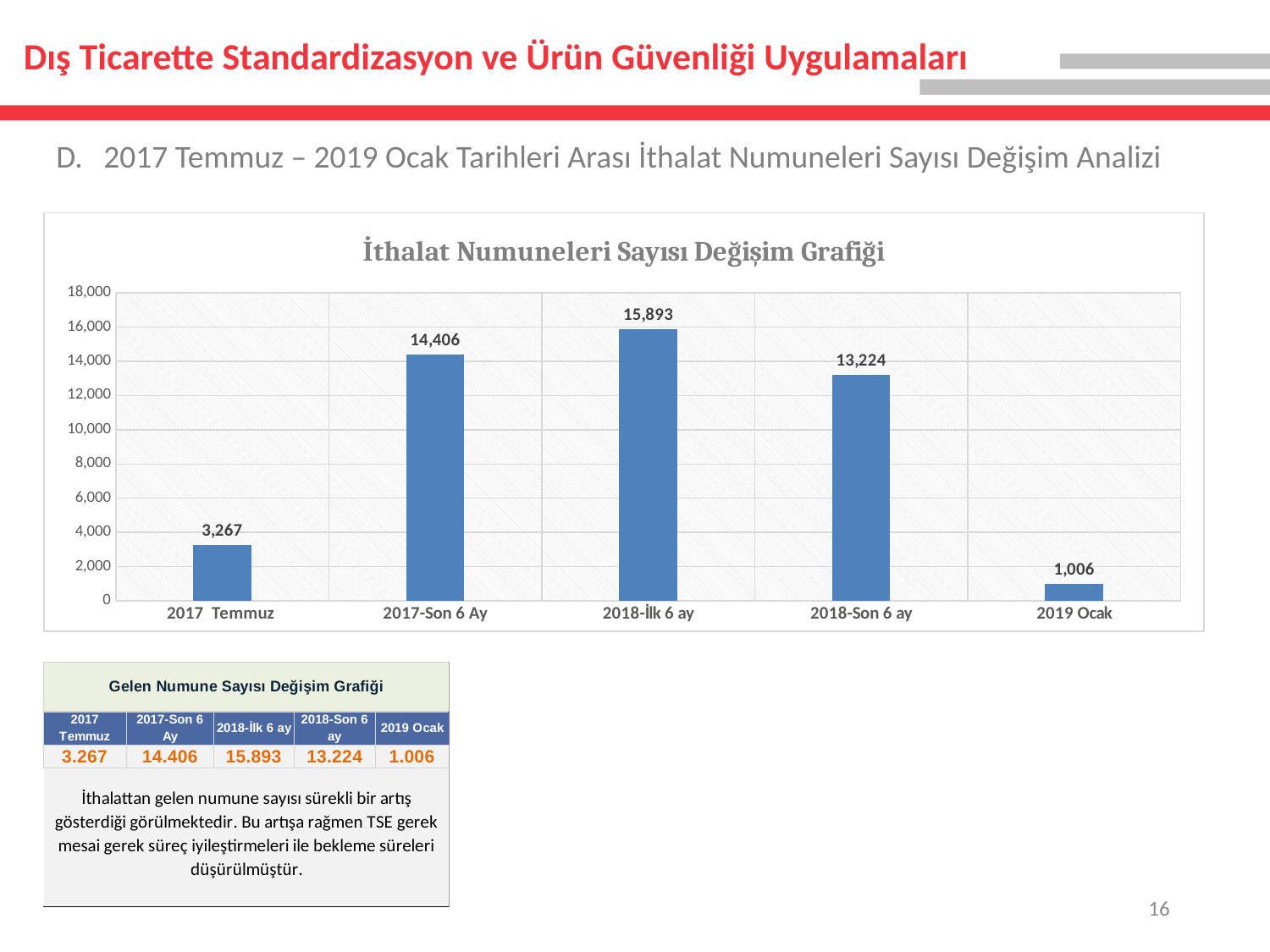
What is the value for 2017 Temmuz in the chart? 3,267 What is the value for 2019 Ocak in the chart? 1,006 Which category has the highest value in the chart? 2018-İlk 6 ay How many categories are shown on the x axis of the chart? 5 Which is larger, the value for 2017-Son 6 Ay or the value for 2018-Son 6 ay? 2017-Son 6 Ay What kind of chart is shown on the slide? bar chart What is the difference between the values for 2017-Son 6 Ay and 2017 Temmuz? 11,139 What is the value for 2018-İlk 6 ay in the chart? 15,893 What is the title of the chart? İthalat Numuneleri Sayısı Değişim Grafiği Which category has the lowest value in the chart? 2019 Ocak Is the value for 2018-Son 6 ay greater or less than 12,000? greater What is the difference between the values for 2018-İlk 6 ay and 2018-Son 6 ay? 2,669